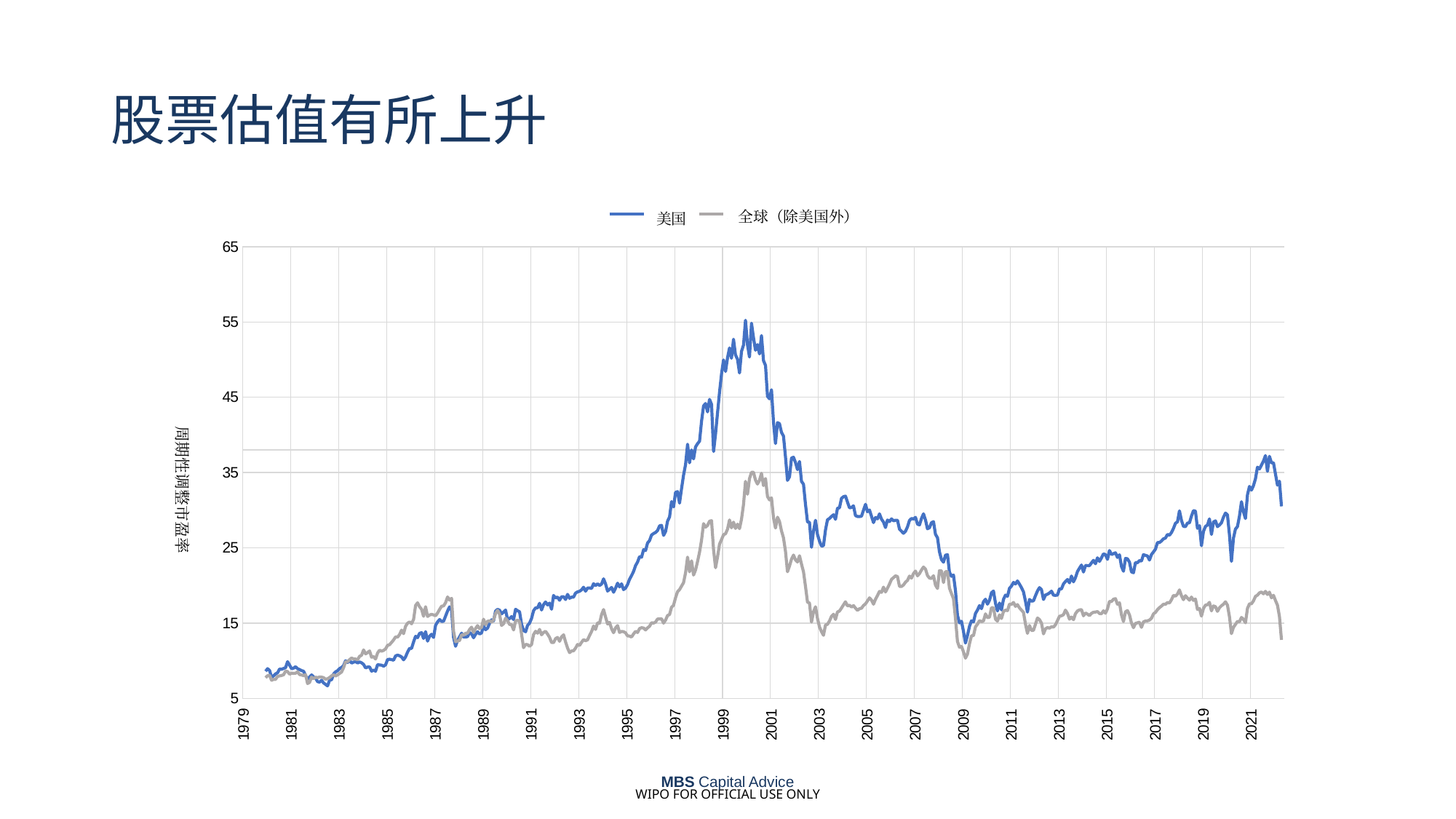
Is the value of the 全球（除美国外） series at its low point around 2009 greater or less than 15? less Is the peak value of the 美国 series around 2000 greater or less than 45? greater Around 1986, which series is higher, 美国 or 全球（除美国外）? 全球（除美国外） Between 2009 and 2021, does the 美国 series generally rise or fall? rise What is the label on the vertical axis? 周期性调整市盈率 What are the two series named in the legend? 美国 and 全球（除美国外） Is the value of the 美国 series at its low point around 2009 greater or less than 25? less What kind of chart is shown on the slide? line chart In 2021, which series is higher, 美国 or 全球（除美国外）? 美国 How many series does the legend list? 2 Around which year does the 美国 series reach its highest value? 2000